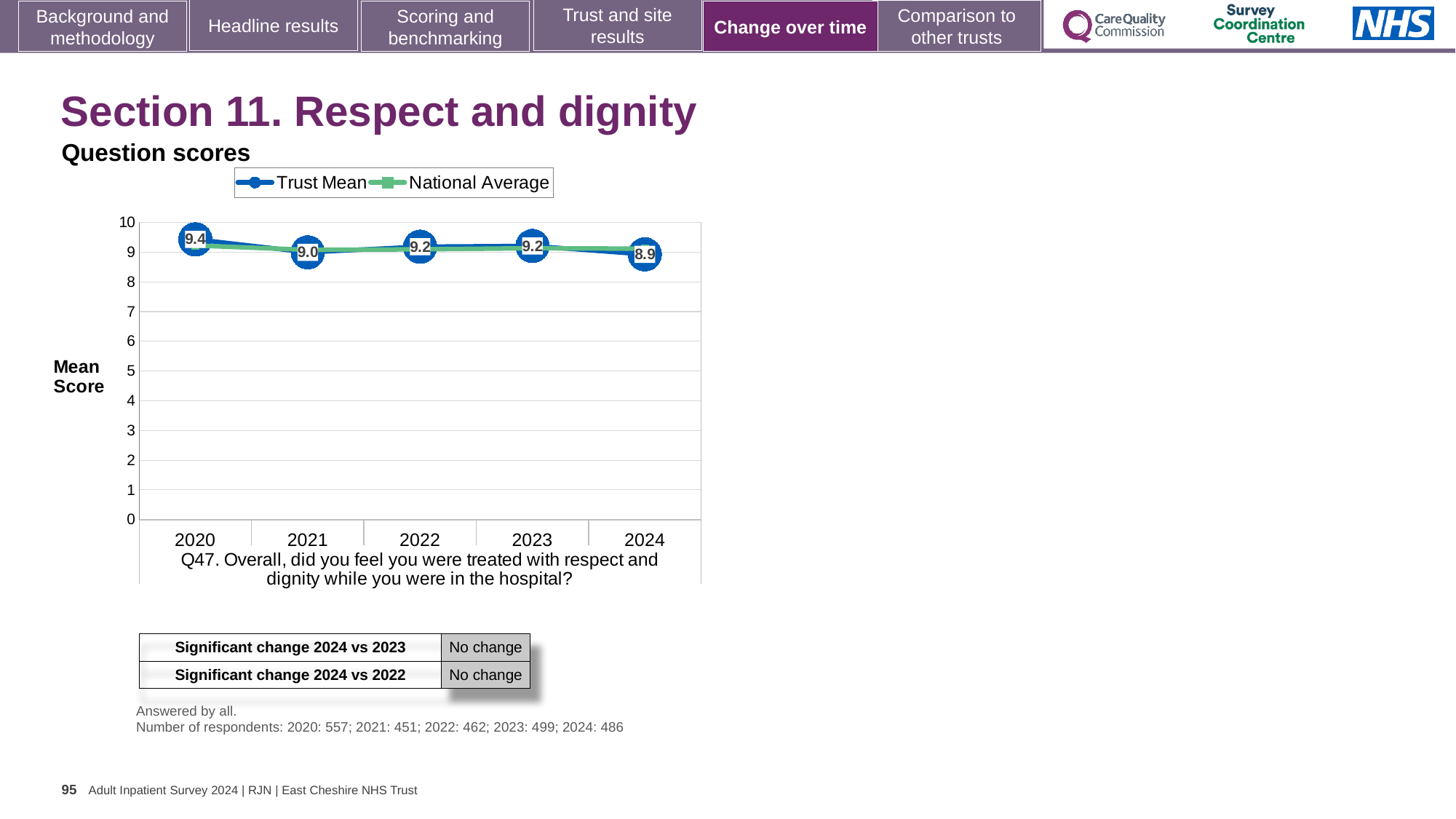
What is the Trust Mean score for 2020? 9.4 Is the National Average value for 2022 greater or less than 8? greater How many series does the chart legend list? 2 What is the difference between the Trust Mean score in 2020 and in 2024? 0.5 How many years are shown on the x axis of the chart? 5 In which year is the Trust Mean score lowest? 2024 What is the label of the y axis of the chart? Mean Score What is the Trust Mean score for 2021? 9.0 What kind of chart is shown on the slide? Line chart In which year is the Trust Mean score highest? 2020 What is the Trust Mean score for 2024? 8.9 Which year has the larger Trust Mean score, 2021 or 2022? 2022